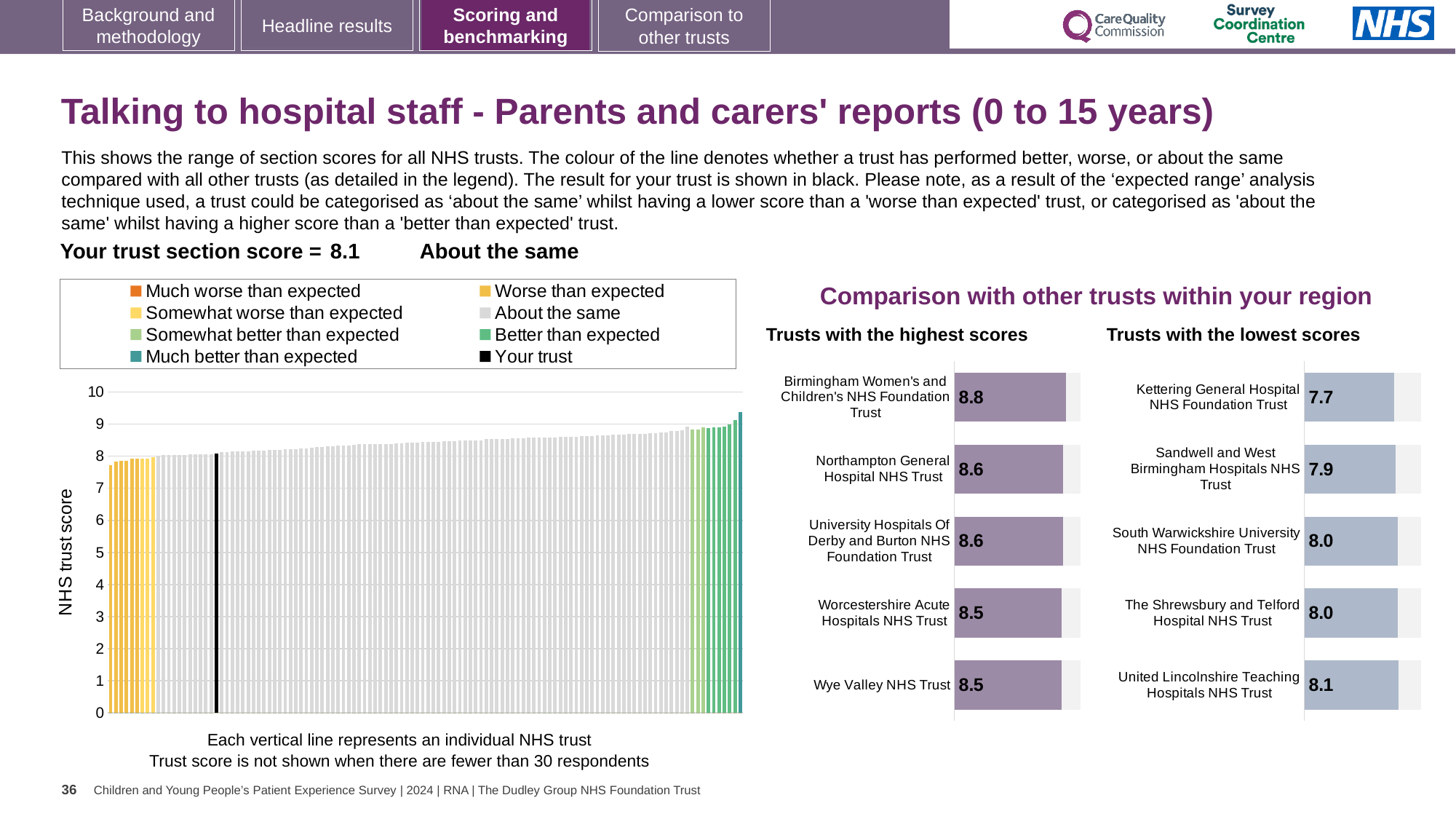
In the 'Trusts with the lowest scores' chart, what is the score for Kettering General Hospital NHS Foundation Trust? 7.7 How many trusts are listed in the 'Trusts with the highest scores' chart? 5 In the 'Trusts with the lowest scores' chart, which trust has the lowest score? Kettering General Hospital NHS Foundation Trust In the 'Trusts with the lowest scores' chart, what is the difference between the scores of United Lincolnshire Teaching Hospitals NHS Trust and Kettering General Hospital NHS Foundation Trust? 0.4 In the large chart on the left showing the range of section scores, do the values rise or fall from left to right along the x axis? rise In the 'Trusts with the highest scores' chart, what is the score for Birmingham Women's and Children's NHS Foundation Trust? 8.8 How many entries does the legend of the large chart on the left list? 8 In the 'Trusts with the highest scores' chart, which trust has the highest score? Birmingham Women's and Children's NHS Foundation Trust What kind of chart is the large chart on the left showing the range of section scores? bar chart In the large chart on the left showing the range of section scores, is the value of the tallest bar greater or less than 9? greater In the 'Trusts with the lowest scores' chart, which has the larger score: Sandwell and West Birmingham Hospitals NHS Trust or The Shrewsbury and Telford Hospital NHS Trust? The Shrewsbury and Telford Hospital NHS Trust In the 'Trusts with the highest scores' chart, what is the difference between the scores of Birmingham Women's and Children's NHS Foundation Trust and Wye Valley NHS Trust? 0.3